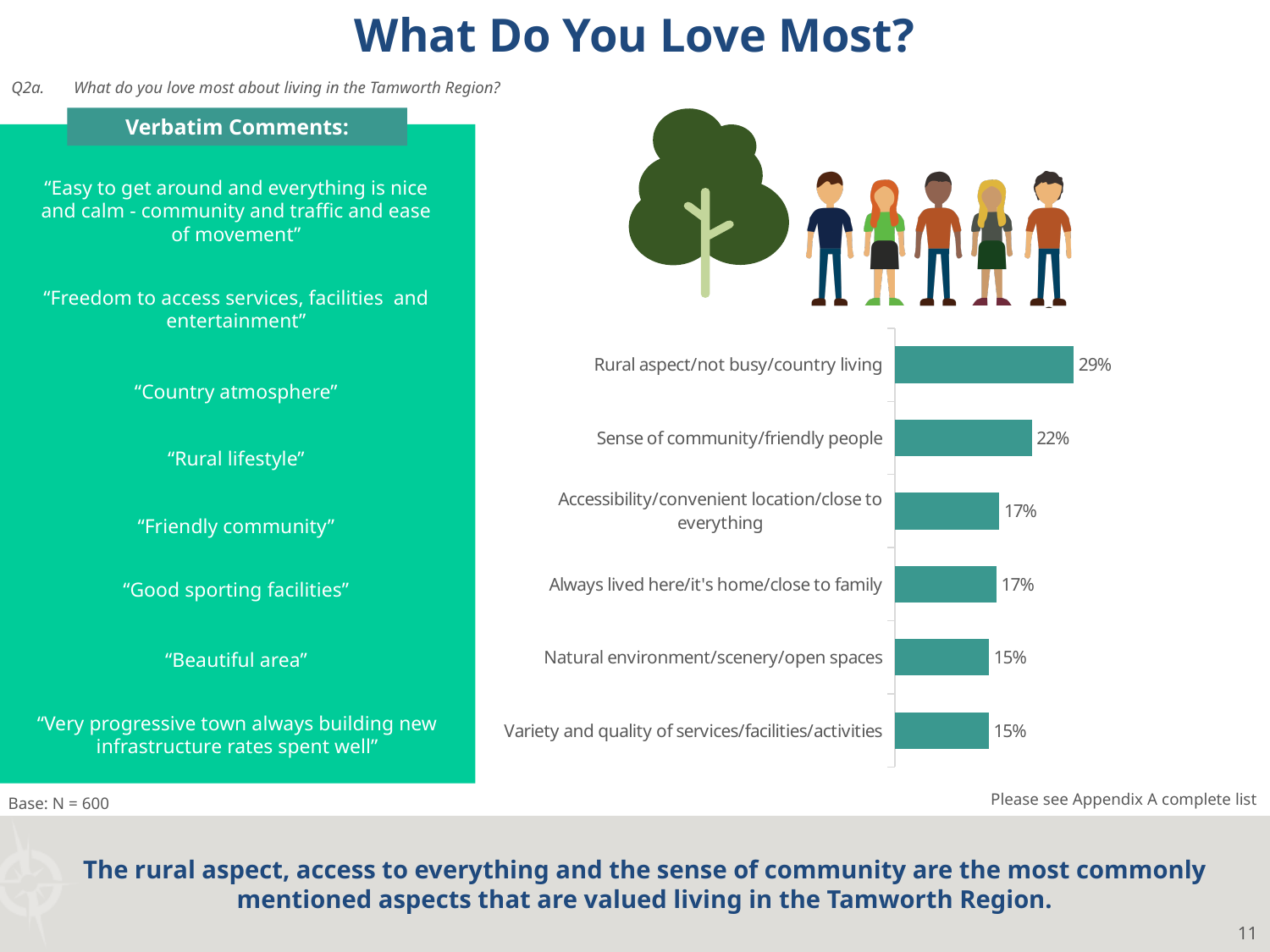
What is the difference between 'Sense of community/friendly people' and 'Always lived here/it's home/close to family'? 5 Do the values rise or fall going from the top bar to the bottom bar? Fall What type of chart is used on this slide? Bar chart Which is larger: 'Sense of community/friendly people' or 'Natural environment/scenery/open spaces'? Sense of community/friendly people What is the value shown for 'Sense of community/friendly people'? 22% What is the value for 'Accessibility/convenient location/close to everything'? 17% Which category has the highest percentage in the chart? Rural aspect/not busy/country living How many categories are shown in the bar chart? 6 What percentage of respondents mentioned 'Rural aspect/not busy/country living'? 29% What is the difference in percentage points between 'Rural aspect/not busy/country living' and 'Sense of community/friendly people'? 7 What percentage is shown for 'Natural environment/scenery/open spaces'? 15% What is the base sample size noted on the slide? N = 600